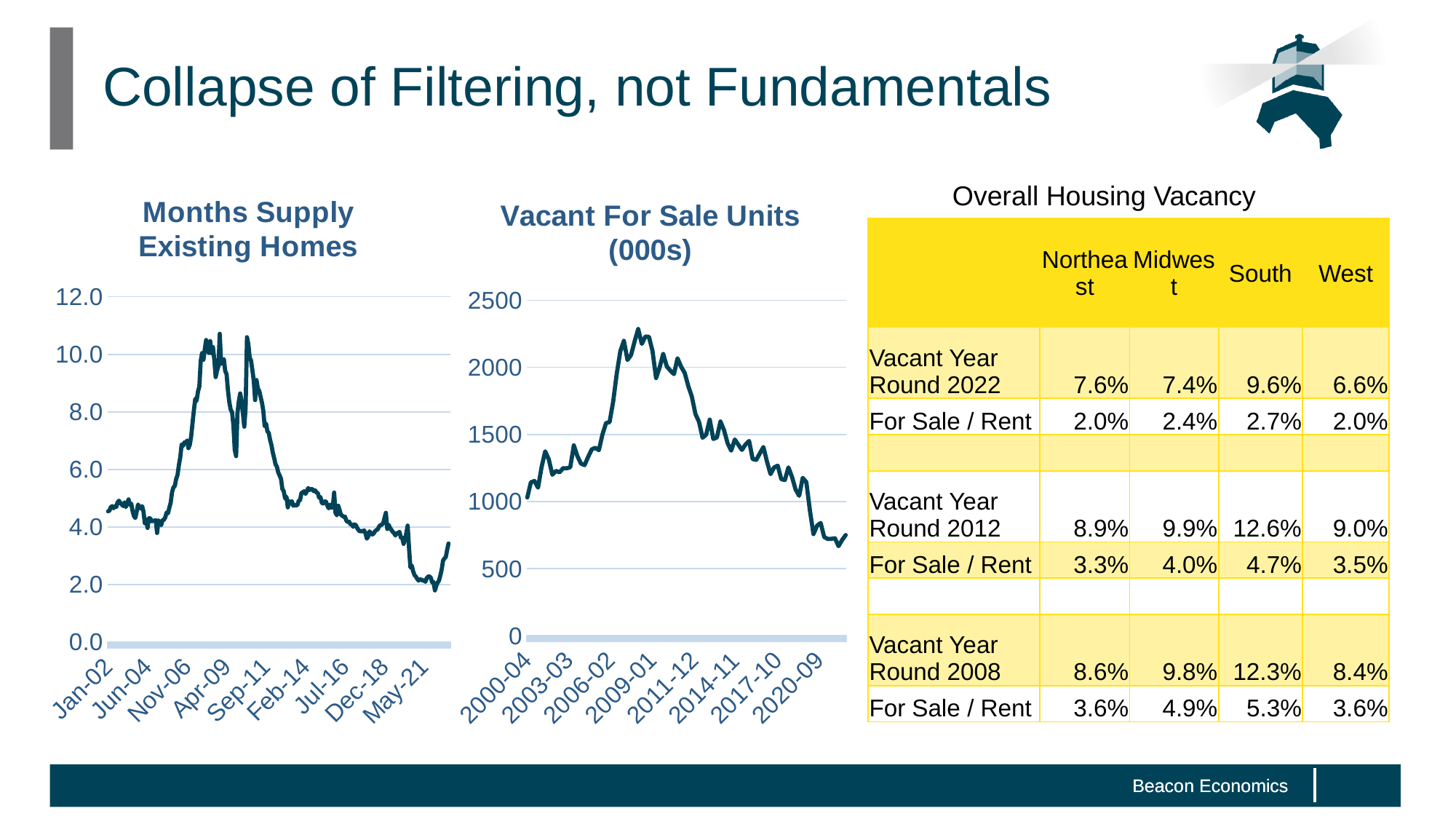
What is the highest value shown on the y axis of the "Vacant For Sale Units (000s)" chart? 2500 What kind of chart is the "Vacant For Sale Units (000s)" chart? line chart In the "Vacant For Sale Units (000s)" chart, do values rise or fall between 2000-04 and 2009-01? rise In the "Vacant For Sale Units (000s)" chart, do values rise or fall between 2009-01 and 2020-09? fall In the "Months Supply Existing Homes" chart, is the peak value around 2009 greater or less than 10.0? greater In the "Vacant For Sale Units (000s)" chart, is the peak value around 2009 greater or less than 2000? greater In the "Months Supply Existing Homes" chart, is the value around Apr-09 larger or smaller than the value around Jan-02? larger What is the first x-axis label on the "Months Supply Existing Homes" chart? Jan-02 What kind of chart is the "Months Supply Existing Homes" chart? line chart In the "Months Supply Existing Homes" chart, is the value at Jan-02 greater or less than 6.0? less